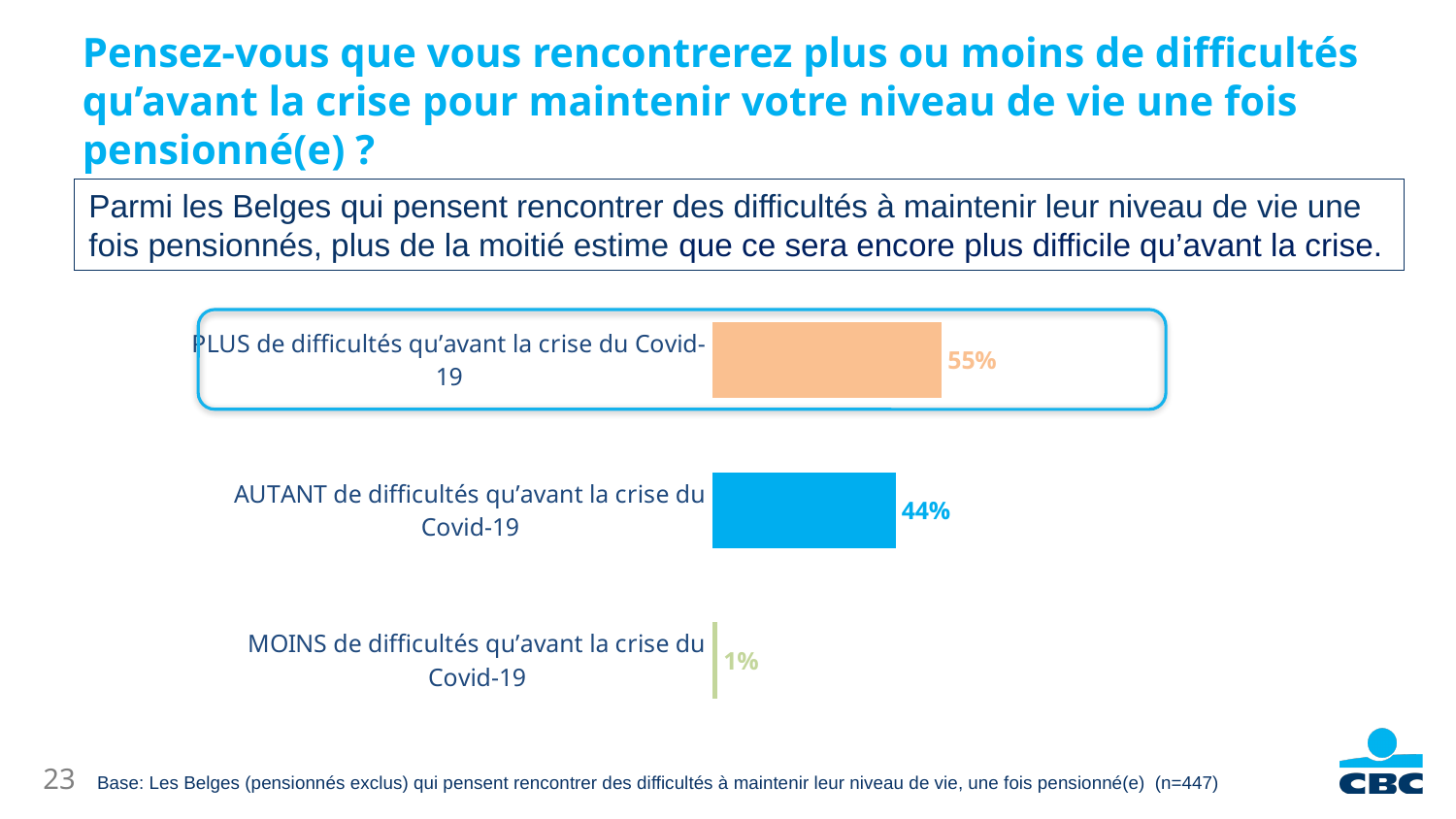
Which category has the highest value? PLUS de difficultés qu'avant la crise du Covid-19 What is the value for "MOINS de difficultés qu'avant la crise du Covid-19"? 1% What colour is the bar for "AUTANT de difficultés qu'avant la crise du Covid-19"? Blue Which is larger: the value for "PLUS de difficultés" or the value for "AUTANT de difficultés"? PLUS de difficultés qu'avant la crise du Covid-19 What is the difference between the values for "PLUS de difficultés" and "AUTANT de difficultés"? 11% How many categories does the chart show? 3 What is the total of the three values shown in the chart? 100% What kind of chart is shown on the slide? Bar chart What is the difference between the values for "AUTANT de difficultés" and "MOINS de difficultés"? 43% Which category has the lowest value? MOINS de difficultés qu'avant la crise du Covid-19 What is the value for "AUTANT de difficultés qu'avant la crise du Covid-19"? 44% What is the value for "PLUS de difficultés qu'avant la crise du Covid-19"? 55%